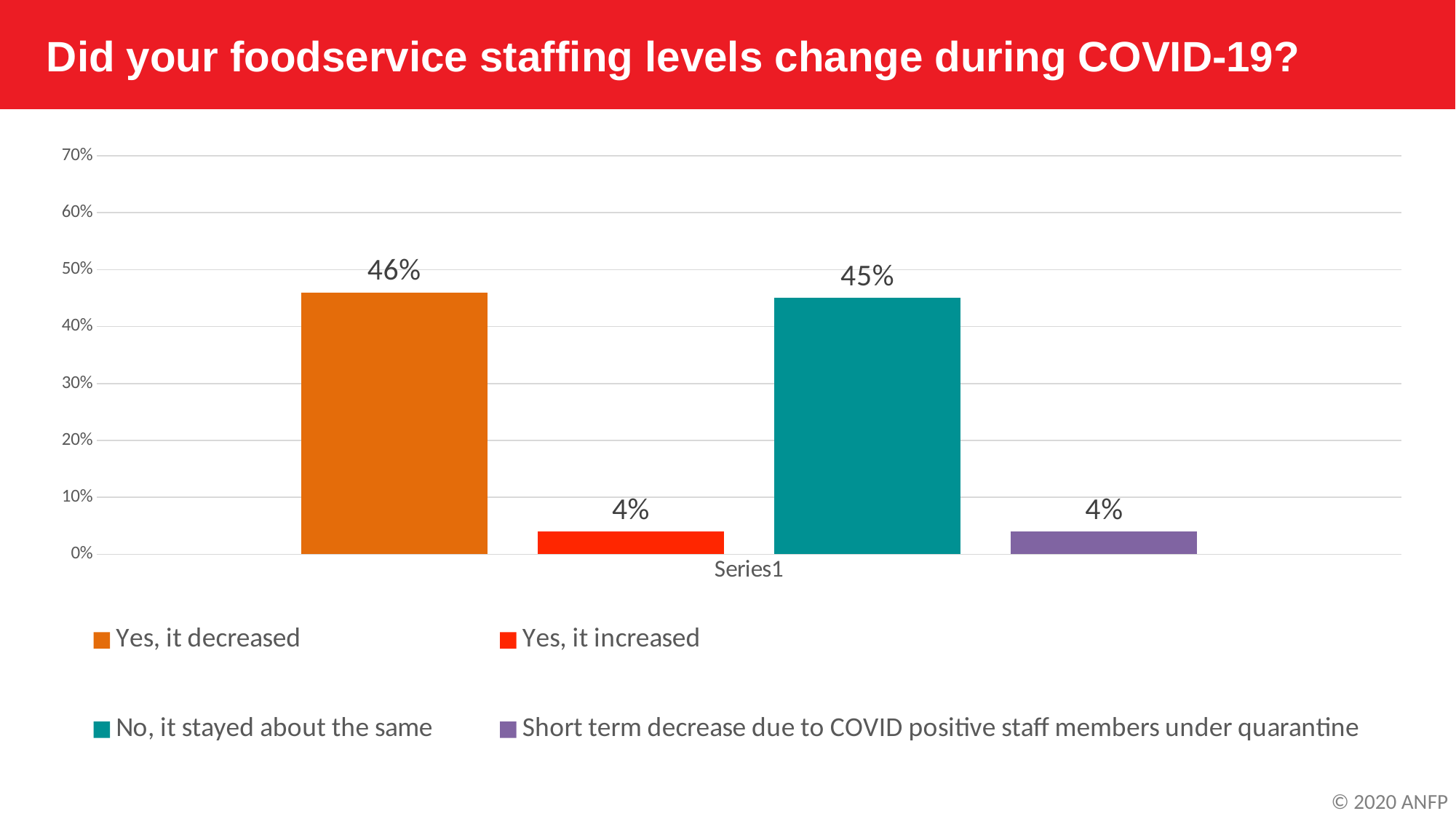
What is the difference in percentage points between 'Yes, it decreased' and 'Yes, it increased'? 42% What kind of chart is shown on the slide? Bar chart What percentage of respondents said their foodservice staffing levels increased? 4% Which response has the highest percentage? Yes, it decreased What percentage of respondents said their foodservice staffing levels decreased? 46% Is the value for 'No, it stayed about the same' greater or less than 40%? greater What colour is the bar for 'No, it stayed about the same'? Teal What percentage of respondents said staffing stayed about the same? 45% What percentage of respondents reported a short term decrease due to COVID positive staff members under quarantine? 4% How many series does the legend list? 4 What is the difference in percentage points between 'Yes, it decreased' and 'No, it stayed about the same'? 1% Which is larger: the percentage for 'Yes, it decreased' or for 'Yes, it increased'? Yes, it decreased